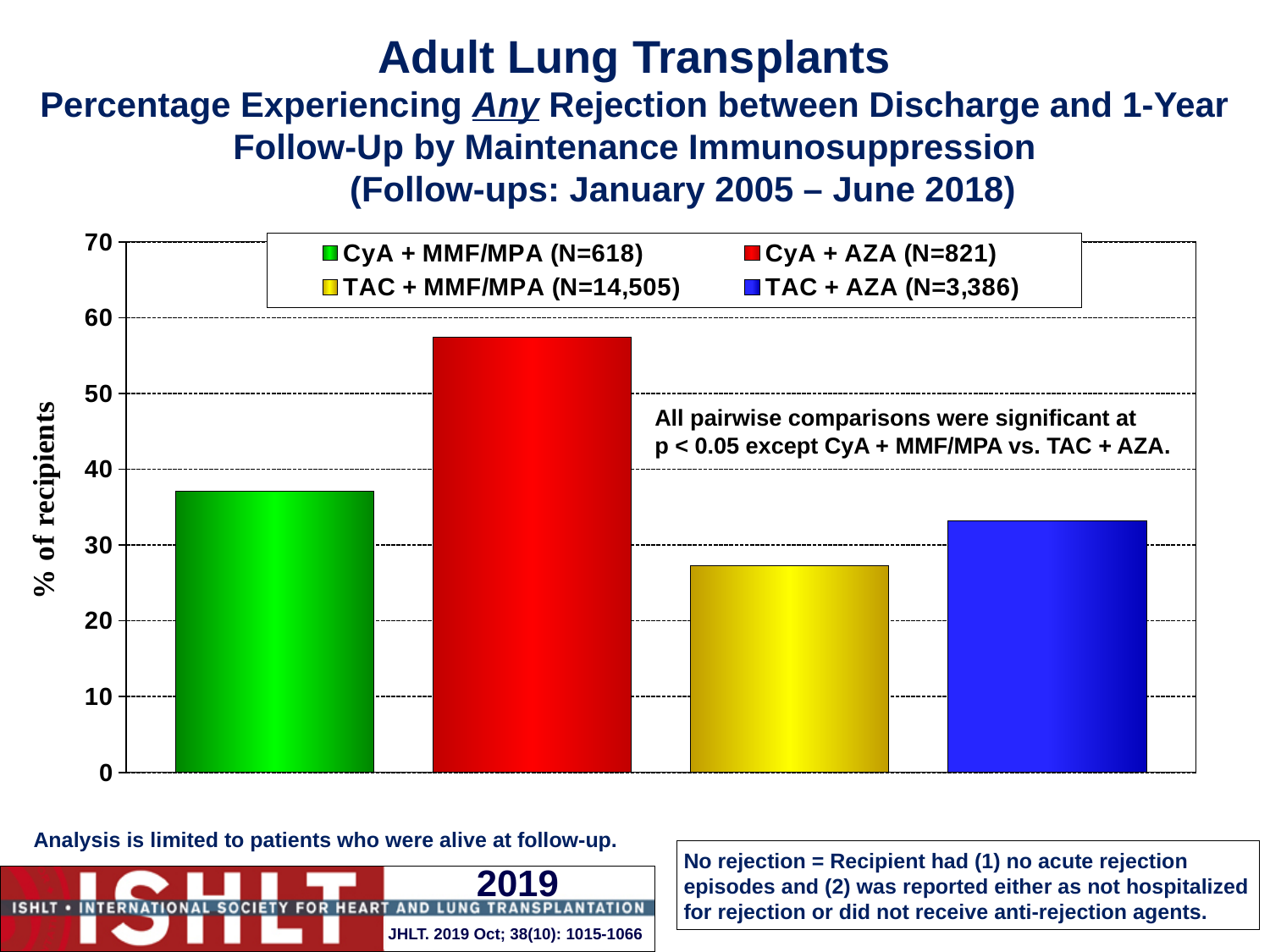
Which maintenance immunosuppression group has the highest percentage of recipients experiencing any rejection? CyA + AZA (N=821) Which is larger, the value for CyA + MMF/MPA or the value for TAC + AZA? CyA + MMF/MPA Is the value for CyA + AZA greater or less than 50? greater Is the value for TAC + AZA greater or less than 30? greater Which maintenance immunosuppression group has the lowest percentage of recipients experiencing any rejection? TAC + MMF/MPA (N=14,505) What kind of chart is shown on the slide? bar chart What is the label of the y axis? % of recipients How many bars are plotted in the chart? 4 Is the value for CyA + MMF/MPA greater or less than 40? less What colour is the bar for TAC + MMF/MPA? yellow How many series does the legend list? 4